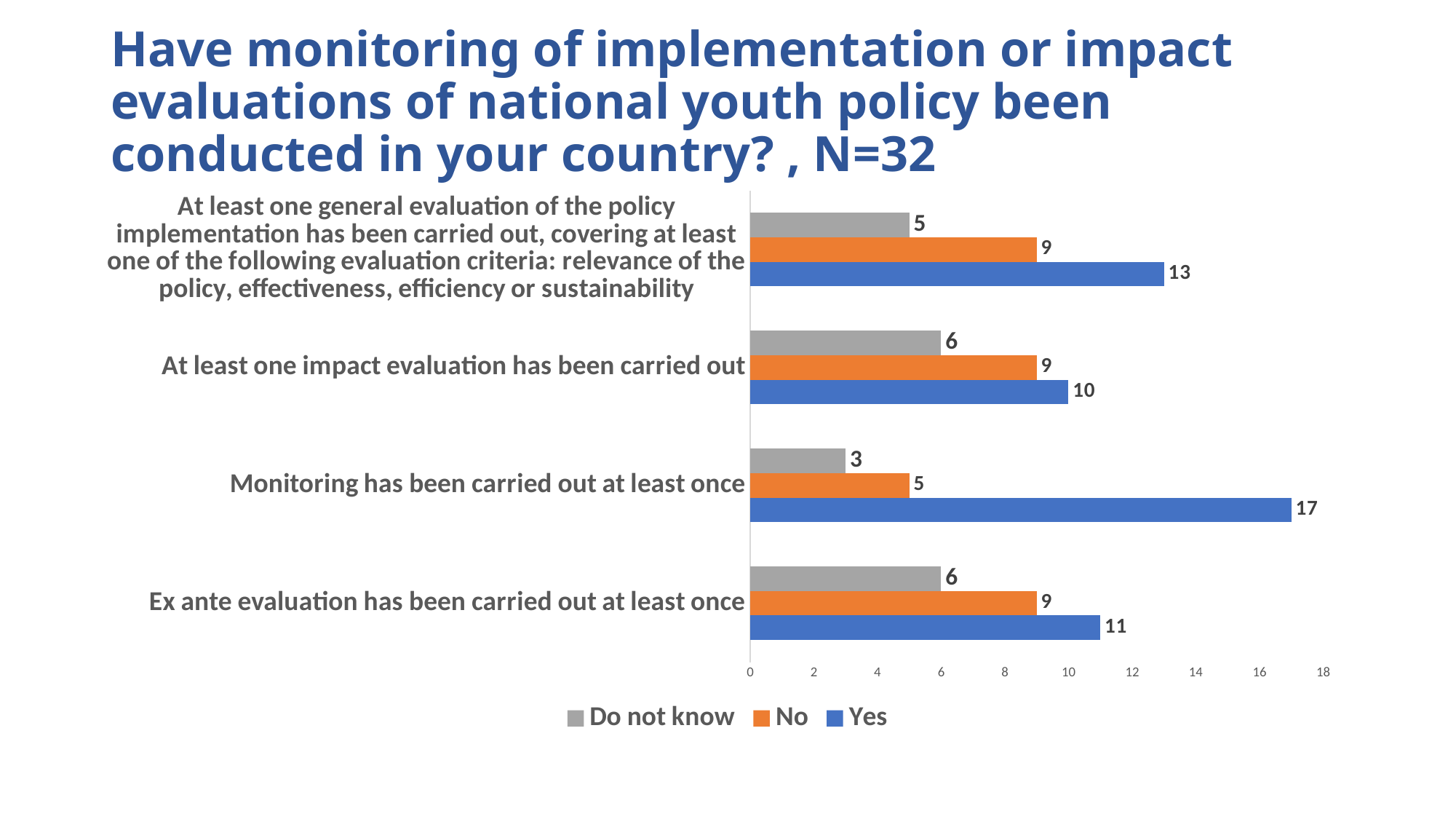
What is the 'Yes' value for 'Monitoring has been carried out at least once'? 17 Which category has the lowest 'Do not know' value? Monitoring has been carried out at least once What is the difference between the 'Yes' and 'No' values for 'Monitoring has been carried out at least once'? 12 Which is larger for 'At least one impact evaluation has been carried out': the 'Yes' value or the 'No' value? Yes How many categories are shown on the chart? 4 How many series does the legend list? 3 What is the 'No' value for 'Ex ante evaluation has been carried out at least once'? 9 What is the total of the 'Yes', 'No' and 'Do not know' values for 'Ex ante evaluation has been carried out at least once'? 26 Which colour represents the 'Yes' series in the legend? Blue What kind of chart is shown on the slide? Bar chart What is the 'Do not know' value for 'At least one impact evaluation has been carried out'? 6 Which category has the highest 'Yes' value? Monitoring has been carried out at least once